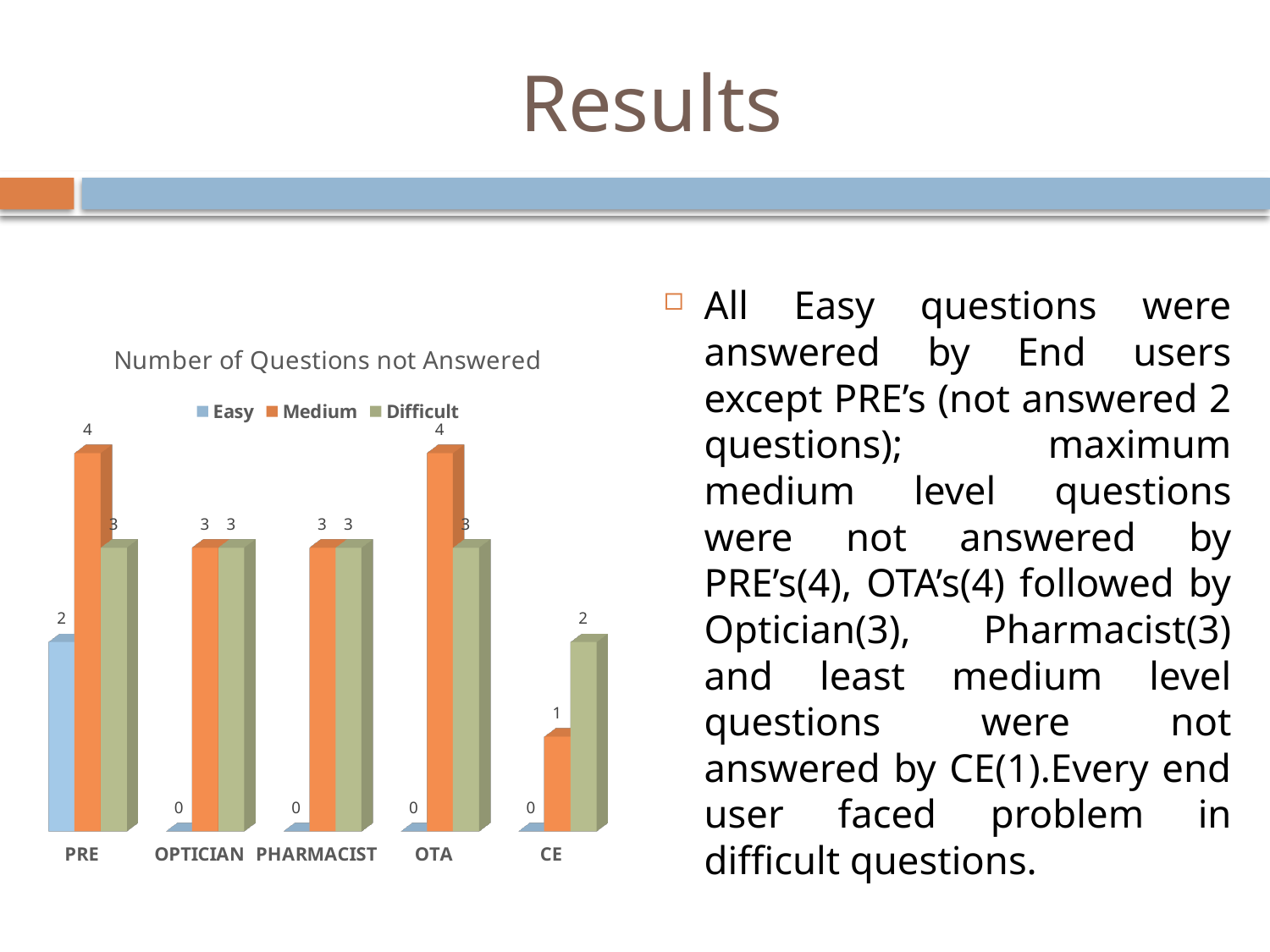
What is the difference between the Medium value for PRE and the Medium value for CE? 3 What is the Difficult value for CE? 2 How many categories are shown on the x axis of the chart? 5 What type of chart is shown on the slide? bar chart Which category has the lowest Medium value? CE What is the Medium value for CE? 1 Which is larger for OPTICIAN, the Easy value or the Medium value? Medium How many series does the chart legend list? 3 Which category has the highest Easy value? PRE What is the title of the chart? Number of Questions not Answered What is the Easy value for PRE? 2 What is the Medium value for PRE? 4